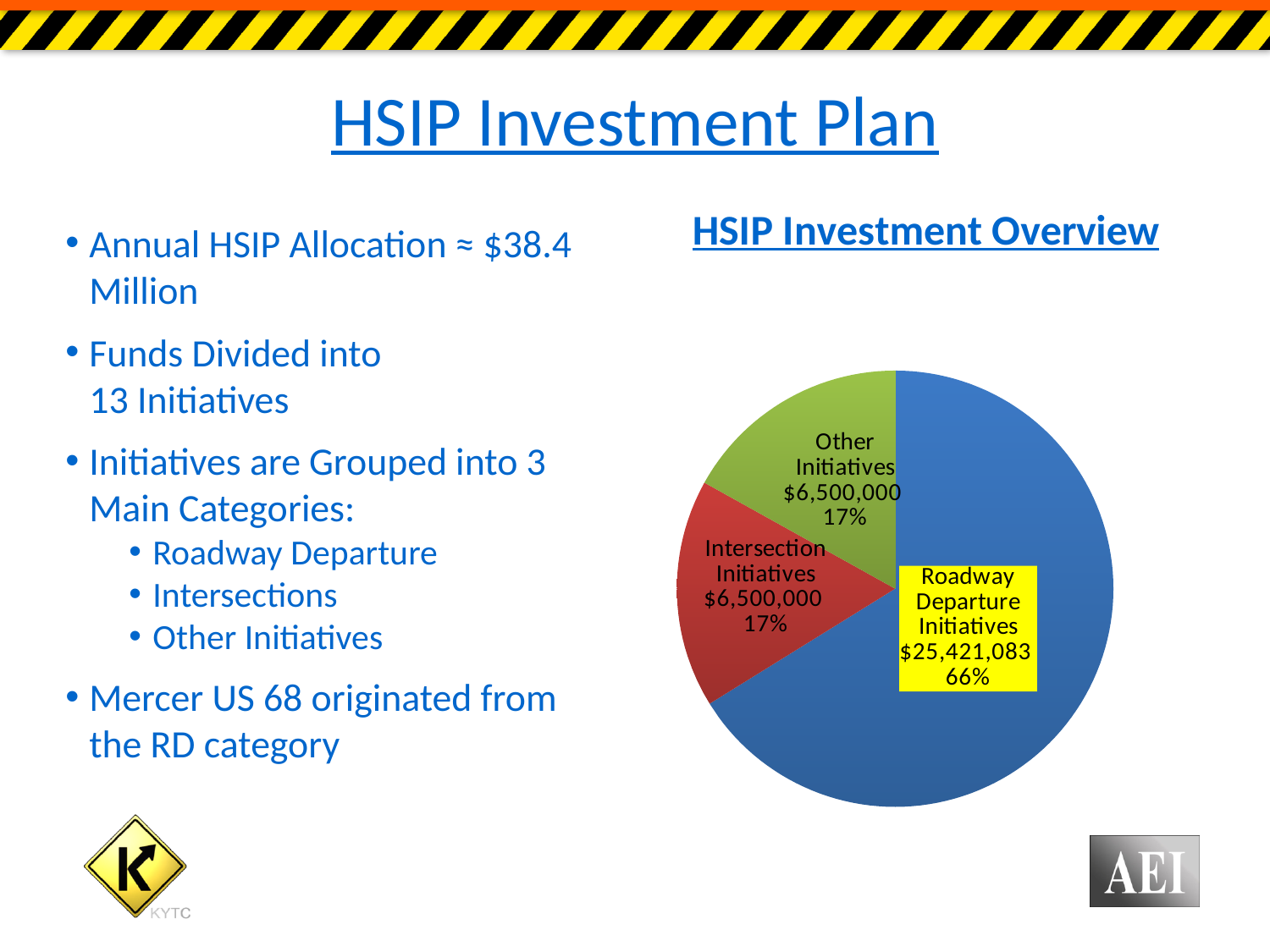
What is the dollar value shown for Intersection Initiatives in the pie chart? $6,500,000 What kind of chart is shown under the title 'HSIP Investment Overview'? pie chart Which is larger in the pie chart, Roadway Departure Initiatives or Other Initiatives? Roadway Departure Initiatives What percentage share of the pie does Other Initiatives have? 17% What colour is the Intersection Initiatives slice in the pie chart? red How many slices does the pie chart have? 3 What is the title of the pie chart? HSIP Investment Overview What percentage share of the pie does Roadway Departure Initiatives have? 66% Which category has the largest slice in the pie chart? Roadway Departure Initiatives What is the dollar value shown for Roadway Departure Initiatives in the pie chart? $25,421,083 What is the dollar value shown for Other Initiatives in the pie chart? $6,500,000 What is the difference in dollars between Roadway Departure Initiatives and Intersection Initiatives? $18,921,083